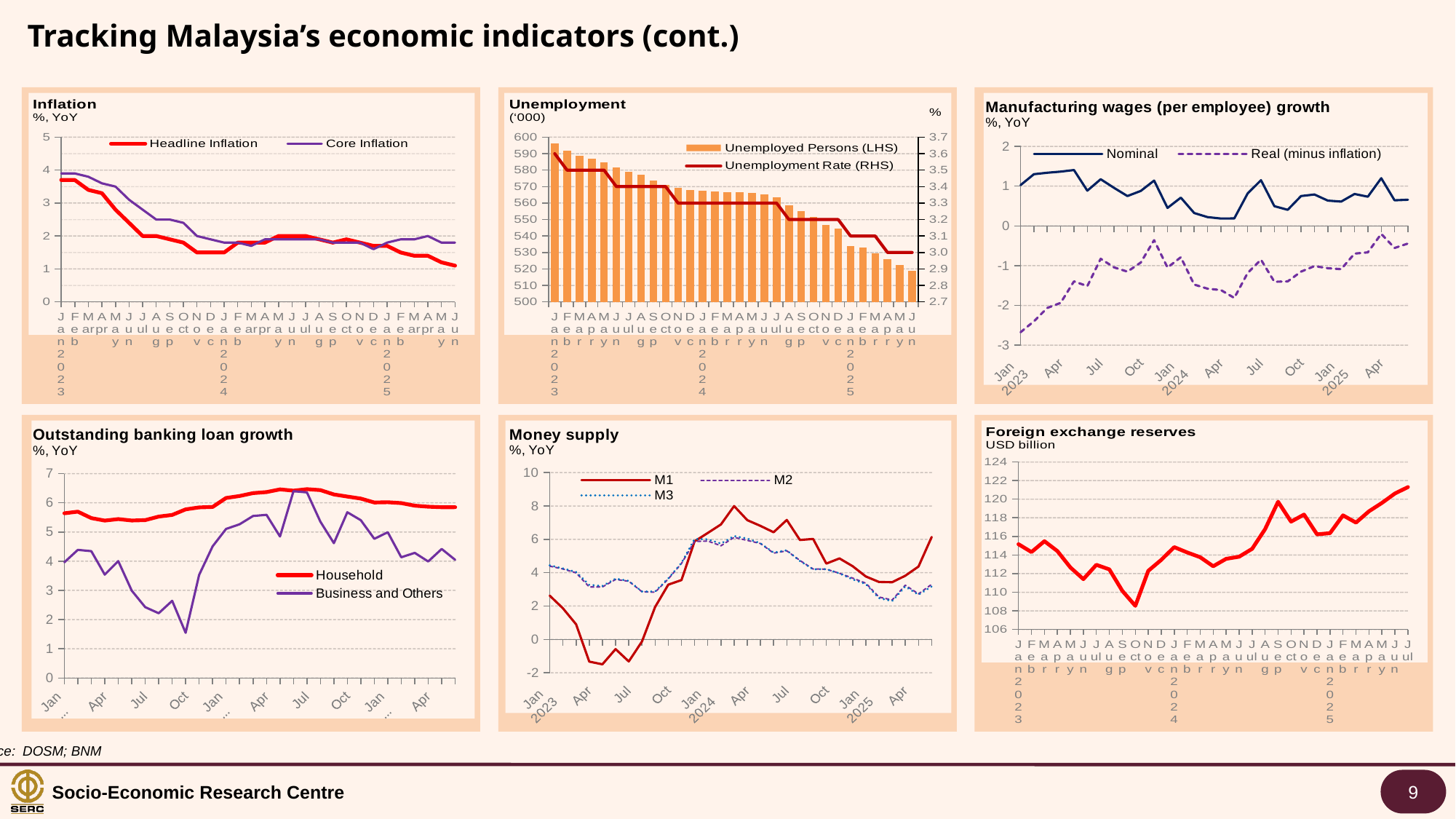
On the Manufacturing wages (per employee) growth chart, is the Real (minus inflation) value at Jan 2023 greater or less than -2? less On the Money supply chart, how many series does the legend list? 3 On the Outstanding banking loan growth chart, is the lowest Business and Others value (around Oct 2023) greater or less than 2? less On the Outstanding banking loan growth chart, is the Household value at Jan 2023 greater or less than 5? greater On the Unemployment chart, do the Unemployed Persons bars rise or fall from Jan 2023 to Jun 2025? Fall On the Inflation chart, how many series does the legend list? 2 On the Manufacturing wages (per employee) growth chart, how many series does the legend list? 2 What kind of chart is the Foreign exchange reserves chart? Line chart On the Unemployment chart, what are the two legend entries? Unemployed Persons (LHS) and Unemployment Rate (RHS) On the Money supply chart, which is larger at Apr 2024, M1 or M2? M1